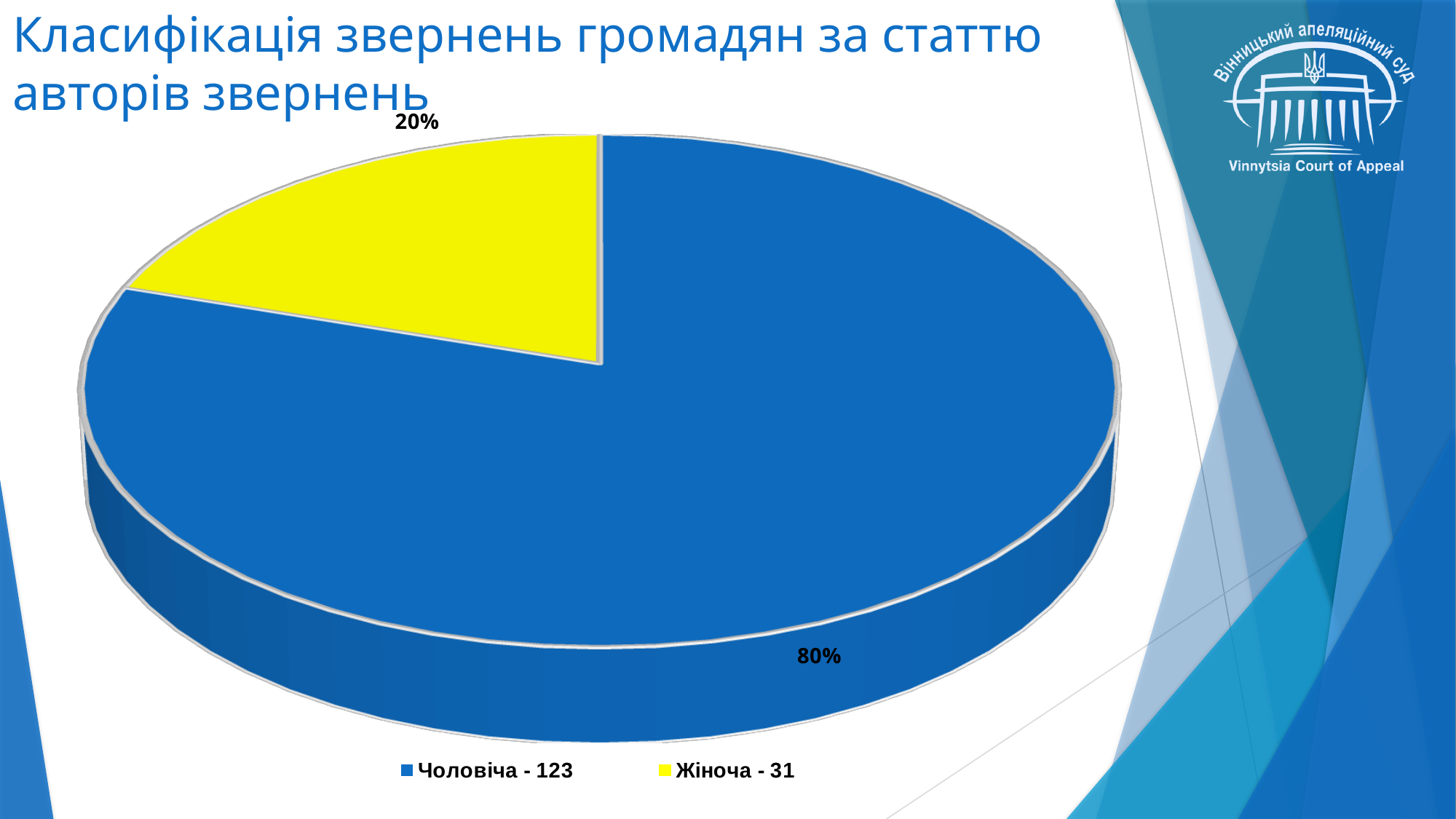
What colour is the slice for "Жіноча - 31"? yellow How many slices does the pie chart have? 2 Which category has the largest slice of the pie? Чоловіча - 123 What is the difference in percentage points between the Чоловіча slice and the Жіноча slice? 60 What percentage of the pie is labelled for the "Жіноча - 31" slice? 20% Which is larger, the share for Чоловіча or the share for Жіноча? Чоловіча What percentage of the pie is labelled for the "Чоловіча - 123" slice? 80% How many entries does the legend list? 2 What kind of chart is shown on the slide? pie chart What number is shown in the legend next to "Жіноча"? 31 What number is shown in the legend next to "Чоловіча"? 123 Which category has the smallest slice of the pie? Жіноча - 31